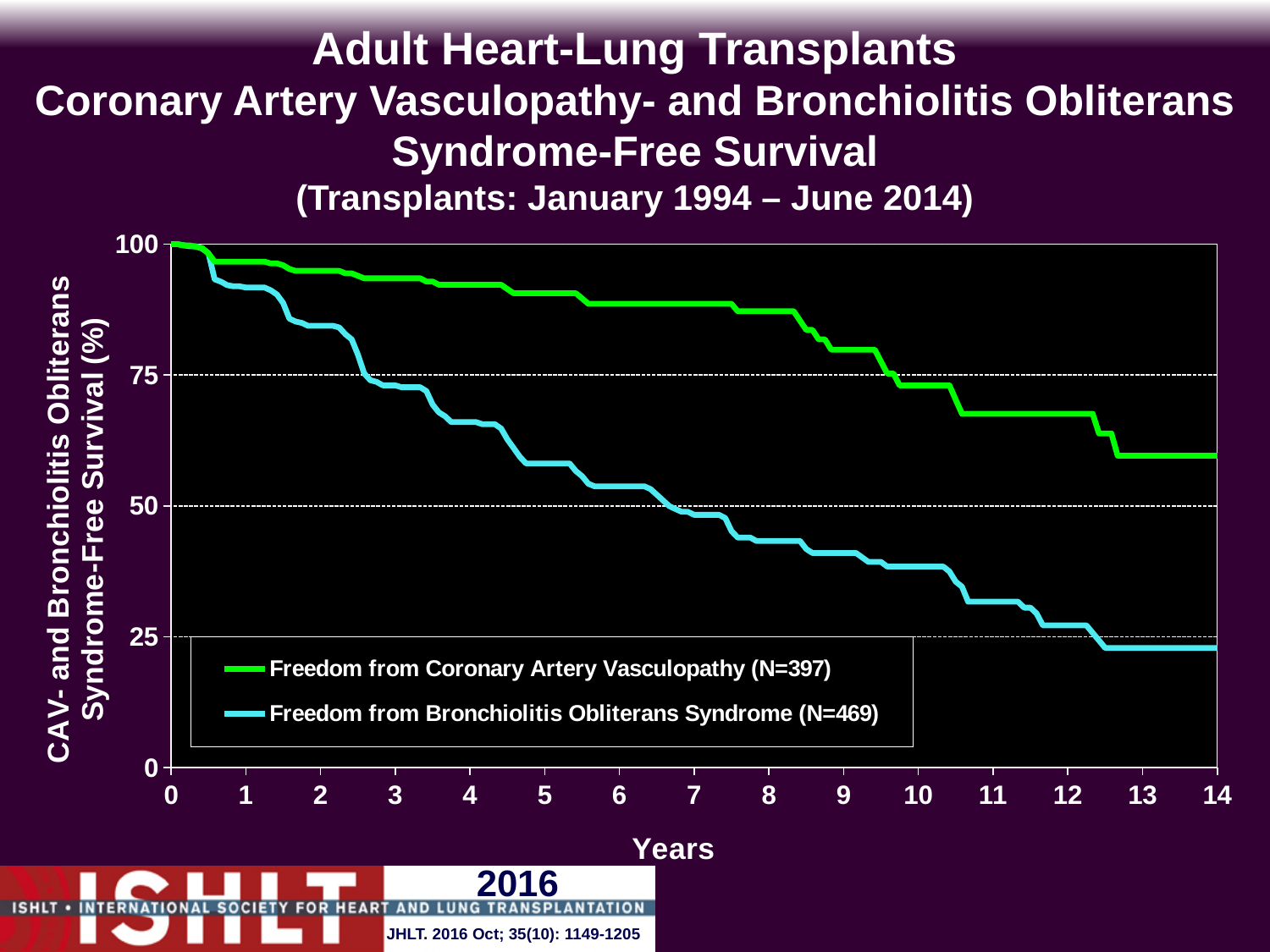
Is the Freedom from Bronchiolitis Obliterans Syndrome value at year 14 greater or less than 25? less What kind of chart is shown on the slide? line chart What is the N for the Freedom from Bronchiolitis Obliterans Syndrome series in the legend? 469 Does the Freedom from Coronary Artery Vasculopathy curve rise or fall over the 14 years? fall What is the N for the Freedom from Coronary Artery Vasculopathy series in the legend? 397 Does the Freedom from Bronchiolitis Obliterans Syndrome curve rise or fall as years increase? fall Is the Freedom from Bronchiolitis Obliterans Syndrome value at year 10 greater or less than 50? less Is the Freedom from Bronchiolitis Obliterans Syndrome value at year 2 greater or less than 75? greater At year 7, which curve is higher: Freedom from Coronary Artery Vasculopathy or Freedom from Bronchiolitis Obliterans Syndrome? Freedom from Coronary Artery Vasculopathy How many series does the legend list? 2